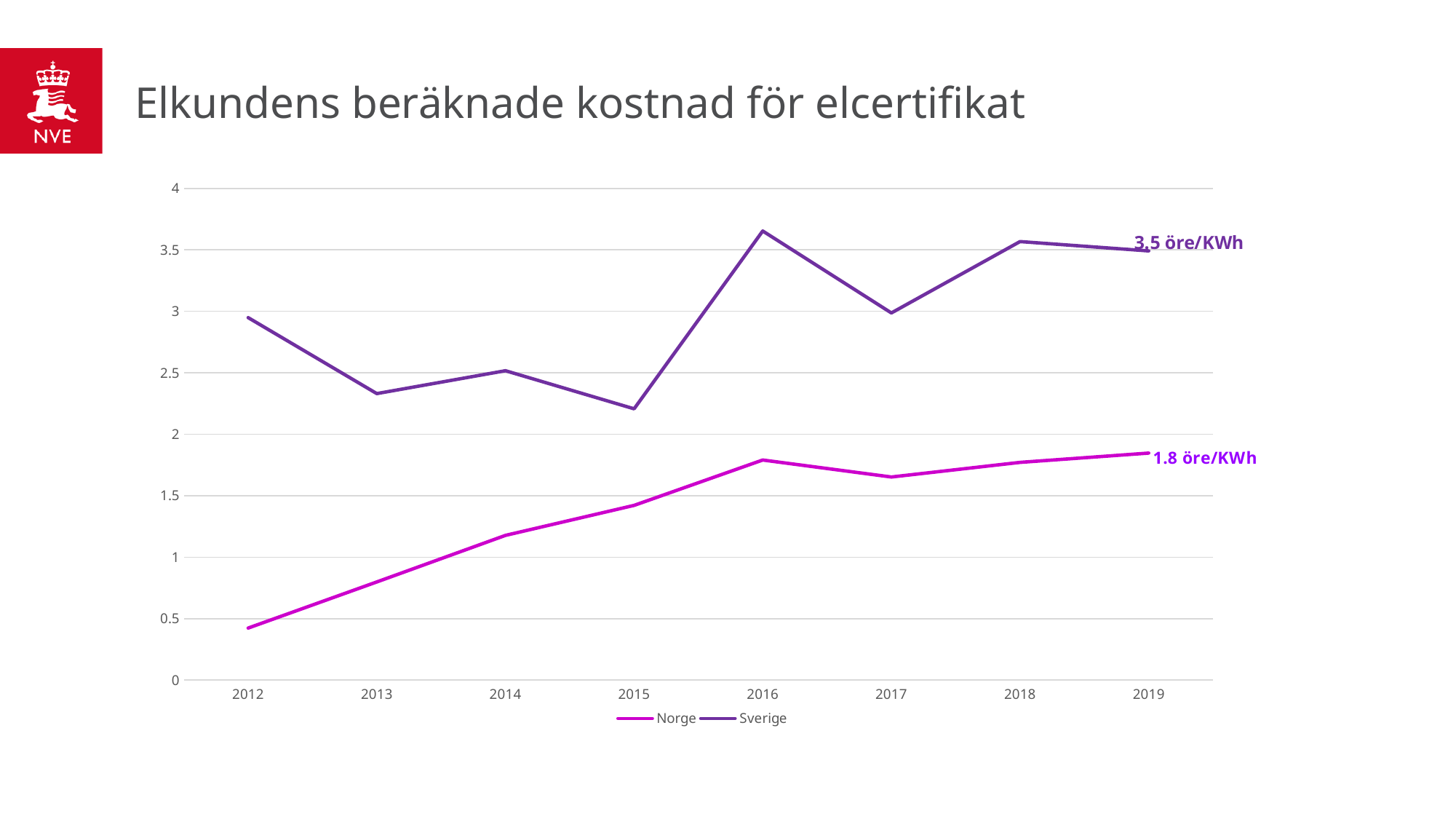
In which year does the Sverige line reach its highest value? 2016 Is the value for Norge in 2012 greater or less than 1? less Is the value for Sverige in 2016 greater or less than 3.5? greater Which series has the higher value in 2019, Norge or Sverige? Sverige What kind of chart is shown on the slide? Line chart What is the value for Norge in 2019? 1.8 öre/KWh How many years are shown on the x axis? 8 What is the difference between the Sverige and Norge values in 2019? 1.6 öre/KWh In which year does the Norge line have its lowest value? 2012 How many series does the legend list? 2 What is the value for Sverige in 2019? 3,5 öre/KWh Is the value for Sverige in 2015 greater or less than 2.5? less